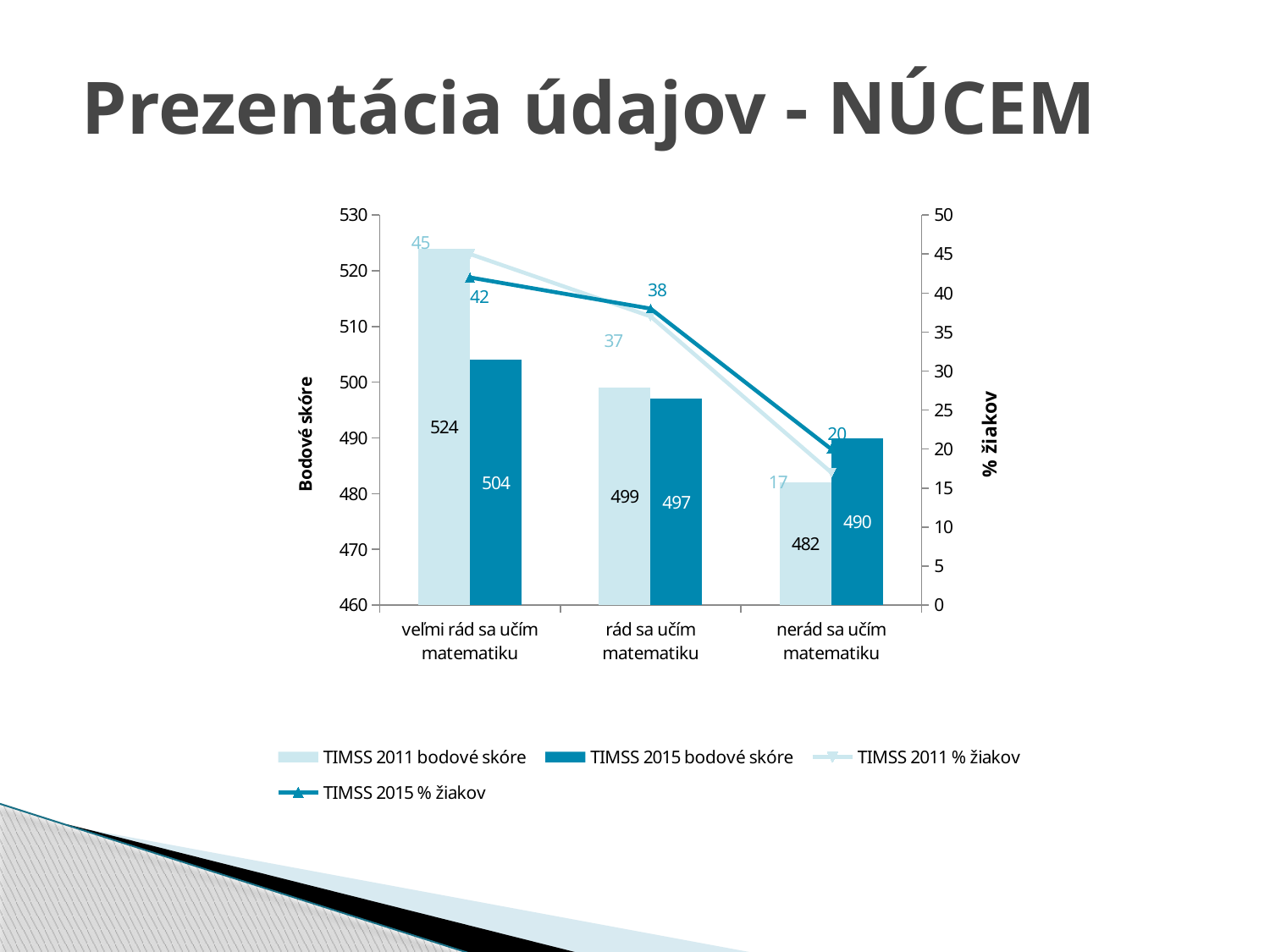
Which is larger for 'nerád sa učím matematiku': the TIMSS 2011 bodové skóre or the TIMSS 2015 bodové skóre? TIMSS 2015 bodové skóre How many categories are shown on the x axis? 3 What is the label of the right-hand vertical axis? % žiakov How does the TIMSS 2015 % žiakov line change from left to right across the categories? It falls What is the TIMSS 2015 bodové skóre for 'nerád sa učím matematiku'? 490 What is the difference between the TIMSS 2011 and TIMSS 2015 bodové skóre for 'veľmi rád sa učím matematiku'? 20 How many series does the legend list? 4 What is the TIMSS 2011 bodové skóre for 'veľmi rád sa učím matematiku'? 524 What is the TIMSS 2011 % žiakov value for 'nerád sa učím matematiku'? 17 What is the TIMSS 2015 % žiakov value for 'rád sa učím matematiku'? 38 Which category has the lowest TIMSS 2011 bodové skóre? nerád sa učím matematiku Which category has the highest TIMSS 2015 bodové skóre? veľmi rád sa učím matematiku